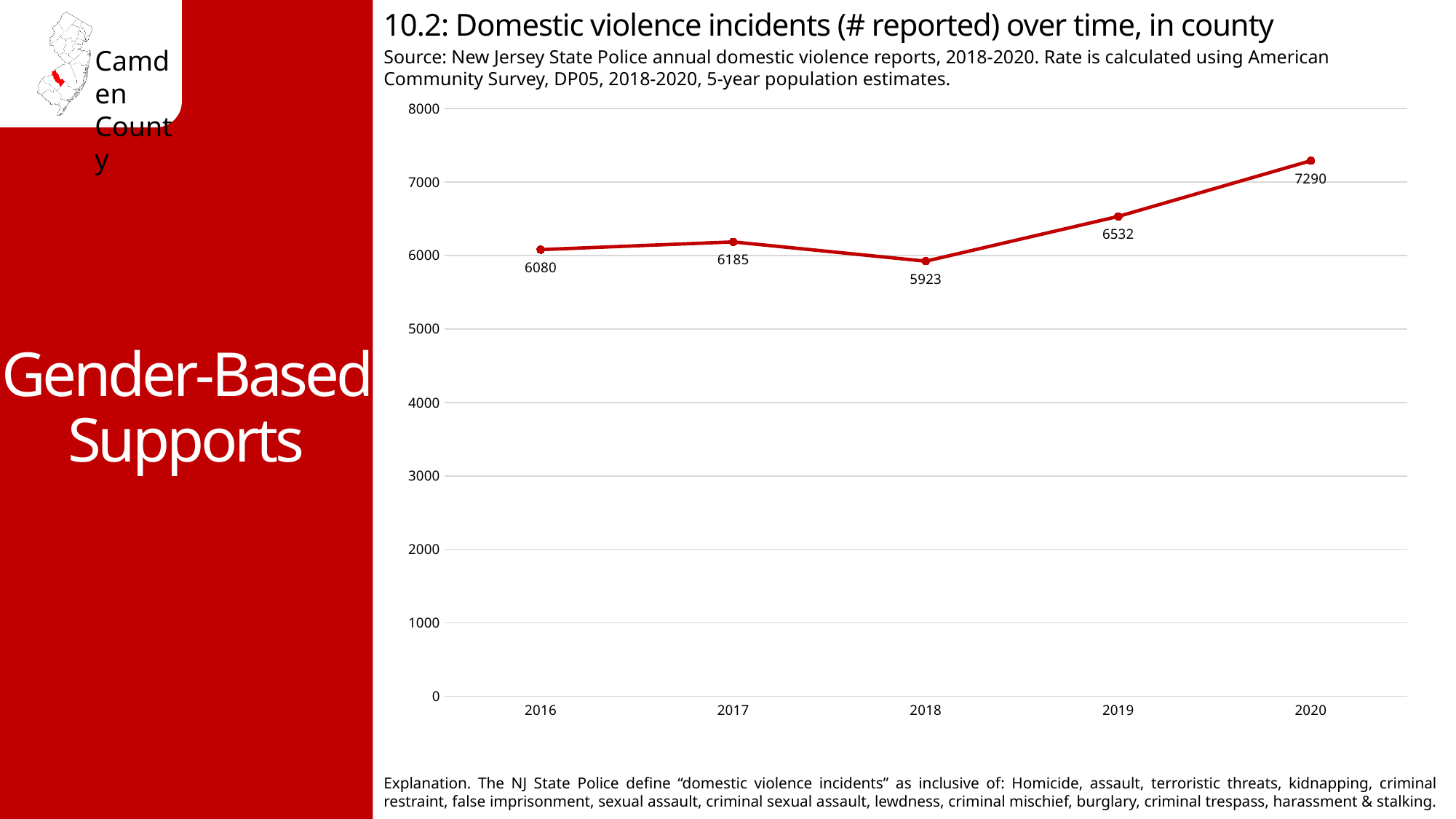
What is the difference between the number of incidents in 2017 and in 2018? 262 Which year has the highest number of reported domestic violence incidents? 2020 Do the values rise or fall from 2018 to 2020? rise How many years are plotted on the chart? 5 What kind of chart is shown on the slide? line chart What is the difference between the number of incidents in 2020 and in 2019? 758 What is the number of reported domestic violence incidents in 2016? 6080 Which year has the lowest number of reported domestic violence incidents? 2018 What is the number of reported domestic violence incidents in 2020? 7290 What is the number of reported domestic violence incidents in 2018? 5923 Which year had more reported incidents, 2017 or 2019? 2019 Is the value for 2020 greater or less than 7000? greater